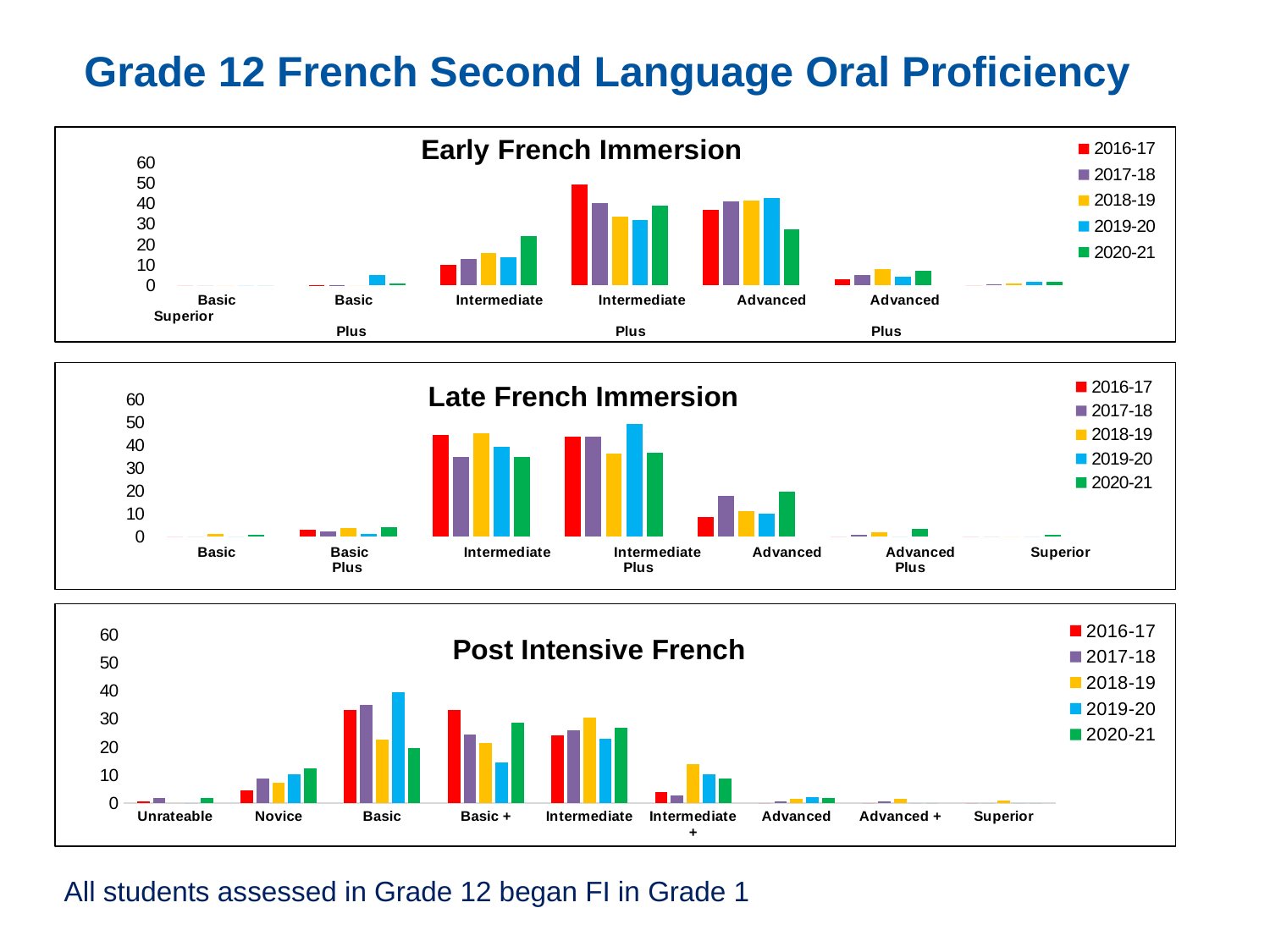
What kind of chart is the Late French Immersion chart? bar chart In the Post Intensive French chart, how many categories are shown on the x axis? 9 In the Late French Immersion chart, for Intermediate Plus, which is larger: the 2019-20 value or the 2018-19 value? 2019-20 In the Early French Immersion chart, is the 2020-21 value for Advanced greater or less than 30? less In the Late French Immersion chart, is the 2016-17 value for Intermediate greater or less than 40? greater In the Early French Immersion chart, which year has the highest value for Intermediate Plus? 2016-17 In the Post Intensive French chart, which year has the highest value for Basic? 2019-20 In the Late French Immersion chart, which year has the highest value for Intermediate Plus? 2019-20 In the Post Intensive French chart, is the 2019-20 value for Basic + greater or less than 20? less In the Early French Immersion chart, how many series does the legend list? 5 In the Late French Immersion chart, how many proficiency categories are shown on the x axis? 7